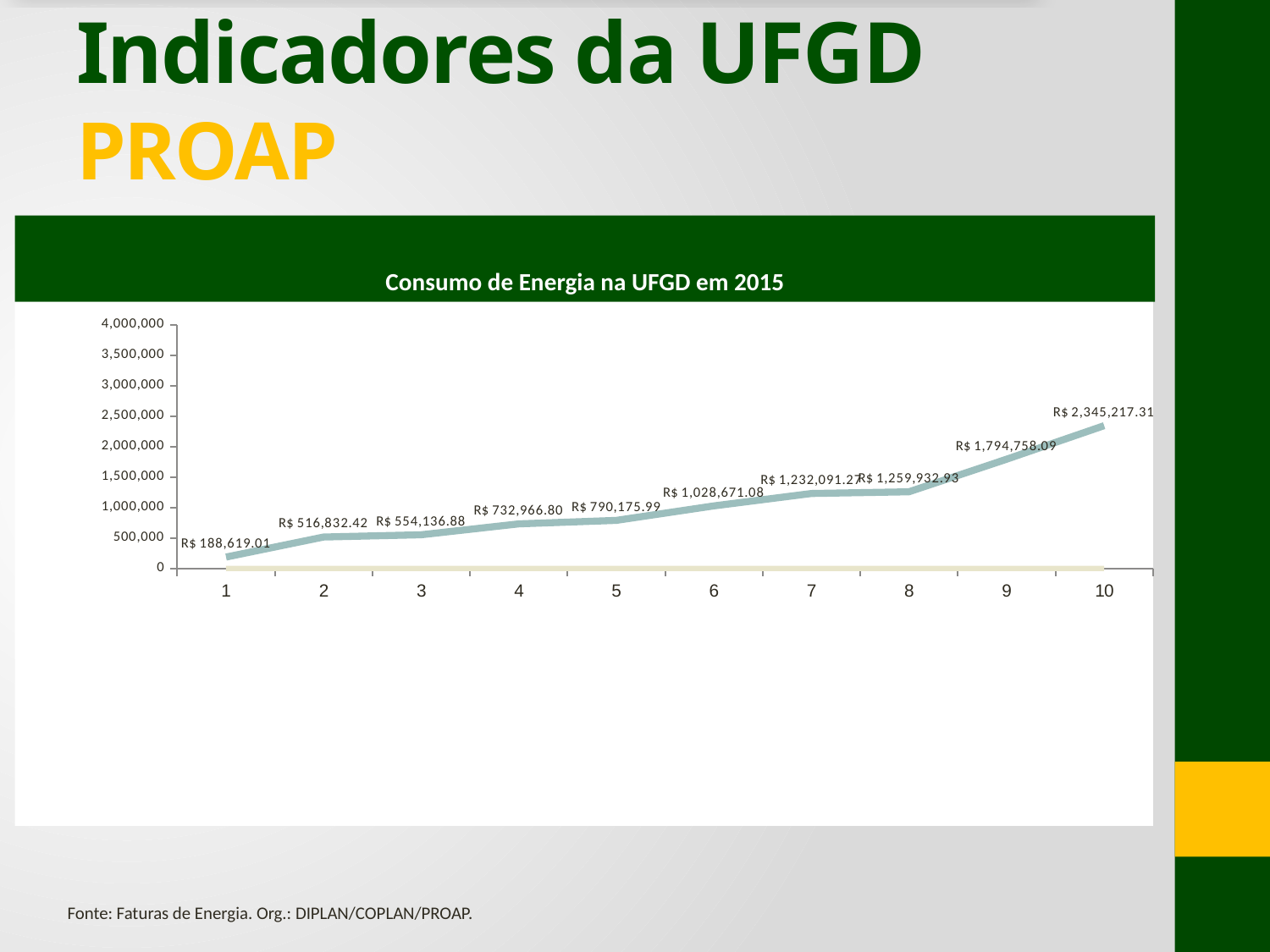
Which point on the x axis has the lowest value? 1 Is the value at point 10 greater or less than 2,000,000? greater What is the value at point 1 on the x axis? R$ 188,619.01 Which is larger, the value at point 4 or the value at point 5? Point 5 What is the difference between the value at point 10 and the value at point 1? R$ 2,156,598.30 What is the value at point 9 on the x axis? R$ 1,794,758.09 Which point on the x axis has the highest value? 10 How many points are plotted along the x axis? 10 What is the value at point 6 on the x axis? R$ 1,028,671.08 What type of chart is shown under the title 'Consumo de Energia na UFGD em 2015'? Line chart Do the values rise or fall from point 1 to point 10? Rise What is the value at point 10 on the x axis? R$ 2,345,217.31